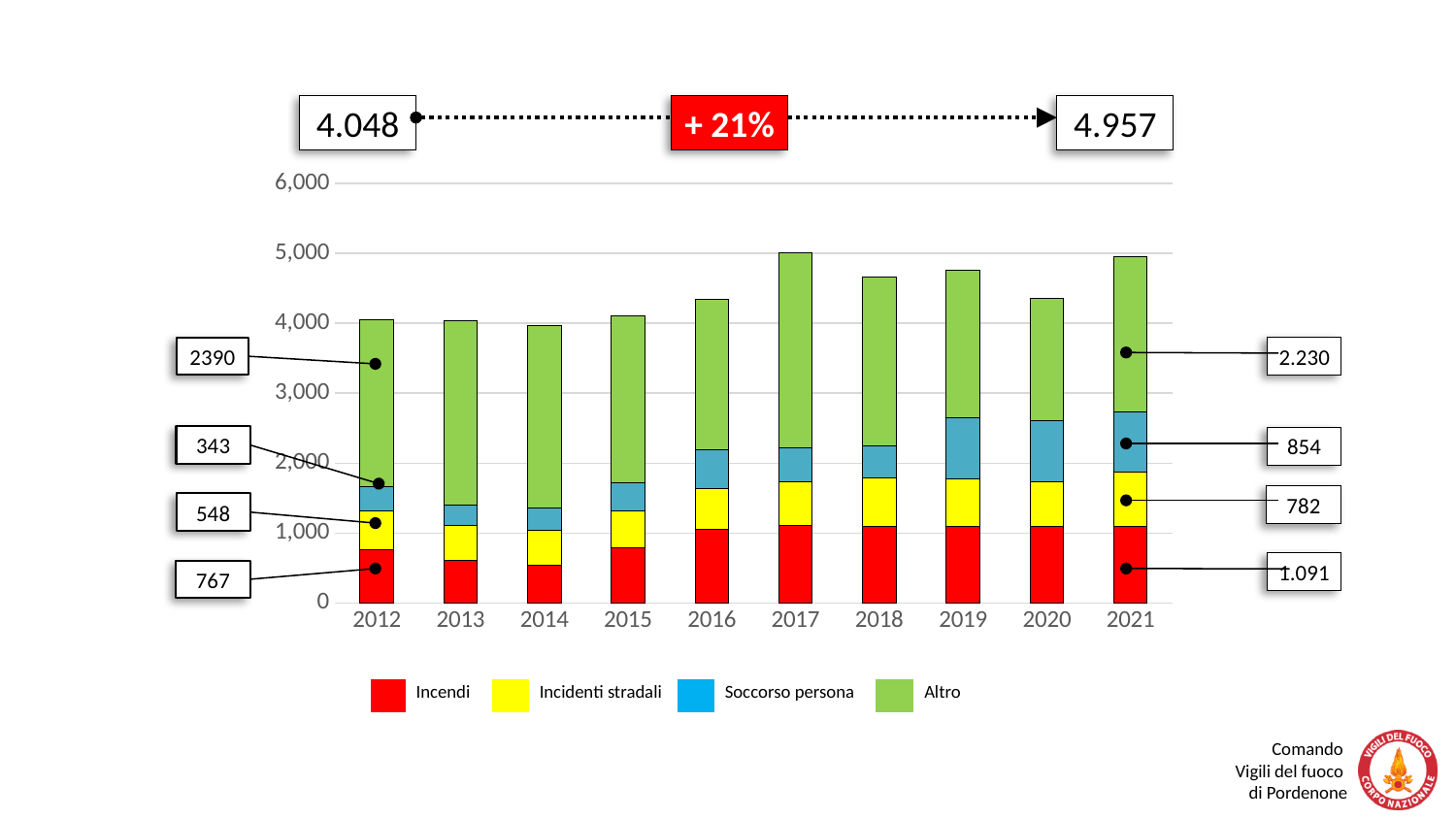
What is the value for Soccorso persona in 2021? 854 By how much did Incendi increase from 2012 (767) to 2021 (1.091)? 324 What is the total of the stacked bar for 2021? 4.957 How many series does the legend list? 4 Is the total for 2017 greater or less than 4,000? greater What is the value for Incidenti stradali in 2012? 548 Which is larger, the Altro value in 2012 or in 2021? 2012 What is the total of the stacked bar for 2012? 4.048 What percentage change is shown between the 2012 and 2021 totals? + 21% What is the value for Incendi in 2012? 767 How many years are shown on the x axis? 10 What is the value for Altro in 2021? 2.230